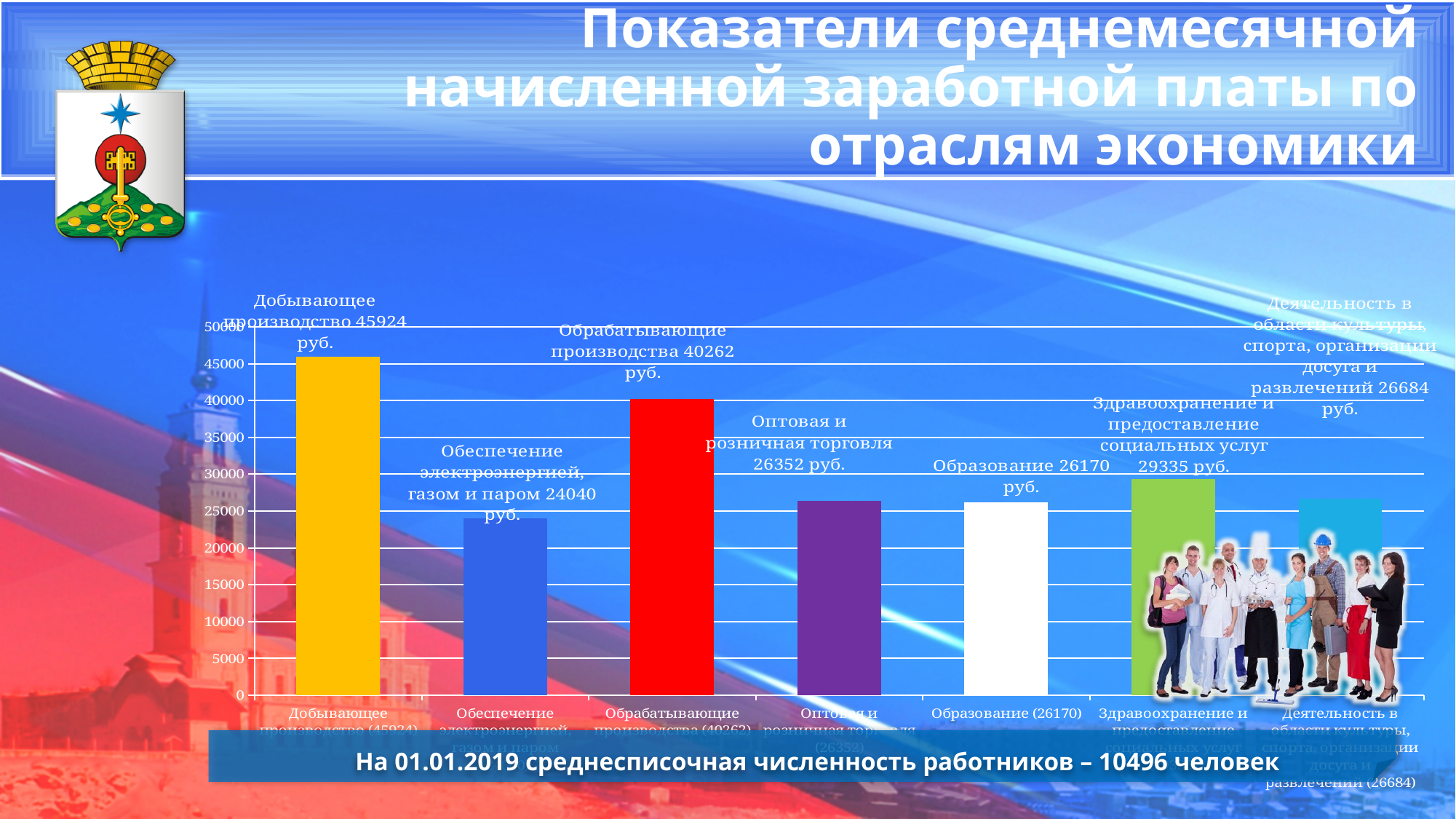
Which is larger: the wage for Здравоохранение и предоставление социальных услуг or for Образование? Здравоохранение и предоставление социальных услуг What kind of chart is shown on the slide? bar chart Is the value for Оптовая и розничная торговля greater or less than 30000? less Which sector has the lowest average monthly wage on the chart? Обеспечение электроэнергией, газом и паром What is the average monthly wage shown for Добывающее производство? 45924 руб. How many sectors (bars) are shown on the chart? 7 Which sector has the highest average monthly wage on the chart? Добывающее производство What value is shown for Здравоохранение и предоставление социальных услуг? 29335 руб. What value is shown for Образование? 26170 руб. What is the difference between the wage for Добывающее производство and Обрабатывающие производства? 5662 руб. What value is shown for Обрабатывающие производства? 40262 руб. What is the difference between the wage for Здравоохранение и предоставление социальных услуг and Обеспечение электроэнергией, газом и паром? 5295 руб.